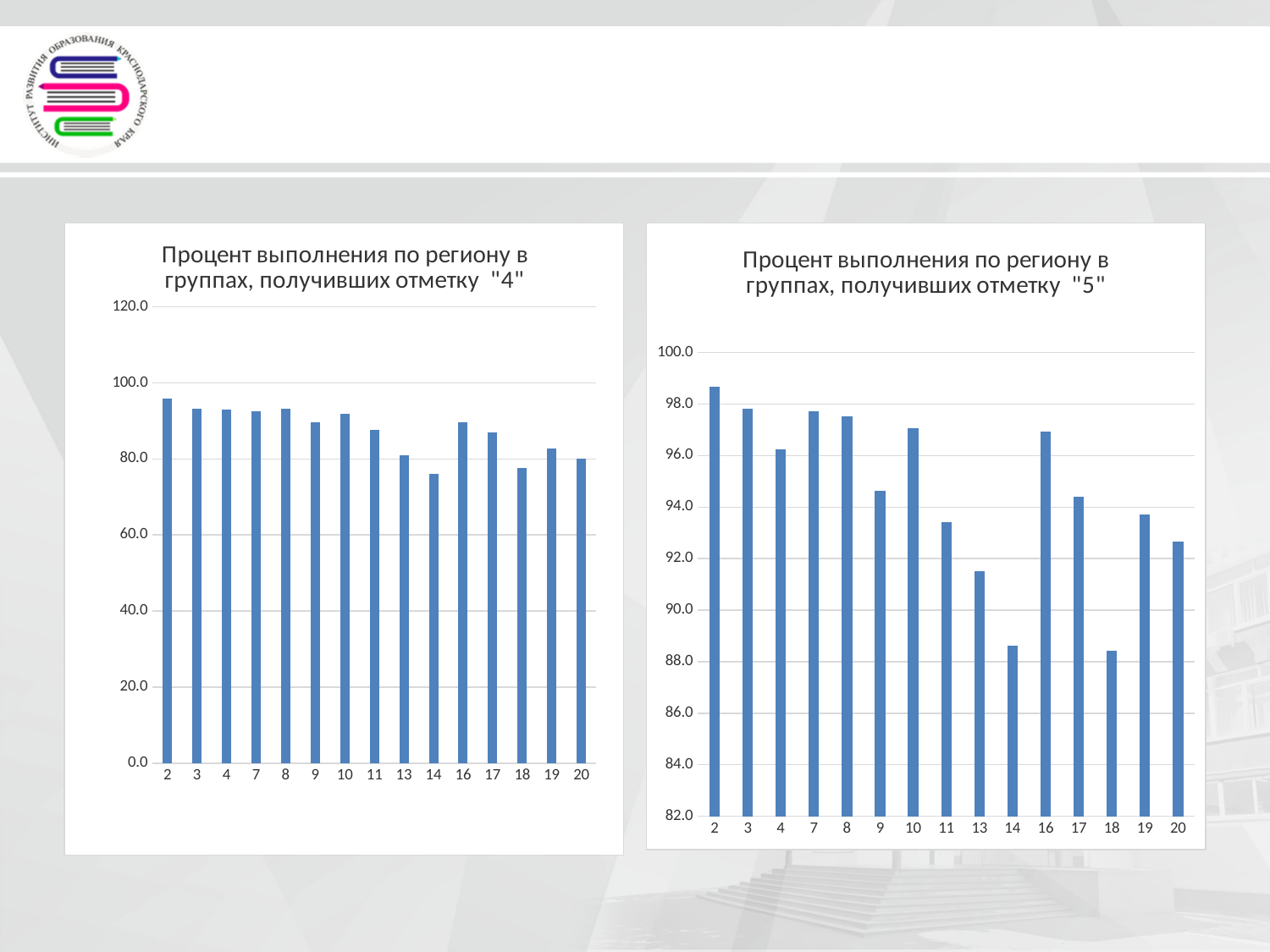
In the right chart (отметку "5"), is the value for category 14 greater or less than 90.0? less In the right chart (отметку "5"), which category has the highest bar? 2 In the right chart (отметку "5"), which is larger, the value for category 4 or the value for category 13? 4 In the right chart (отметку "5"), is the value for category 13 greater or less than 90.0? greater What is the highest tick value shown on the y axis of the left chart (отметку "4")? 120.0 In the left chart (отметку "4"), is the value for category 2 greater or less than 80.0? greater How many categories are shown on the x axis of the right chart (отметку "5")? 15 In the left chart (отметку "4"), which is larger, the value for category 10 or the value for category 14? 10 In the left chart (отметку "4"), which category has the highest bar? 2 What kind of chart is the left chart, titled 'Процент выполнения по региону в группах, получивших отметку "4"'? bar chart